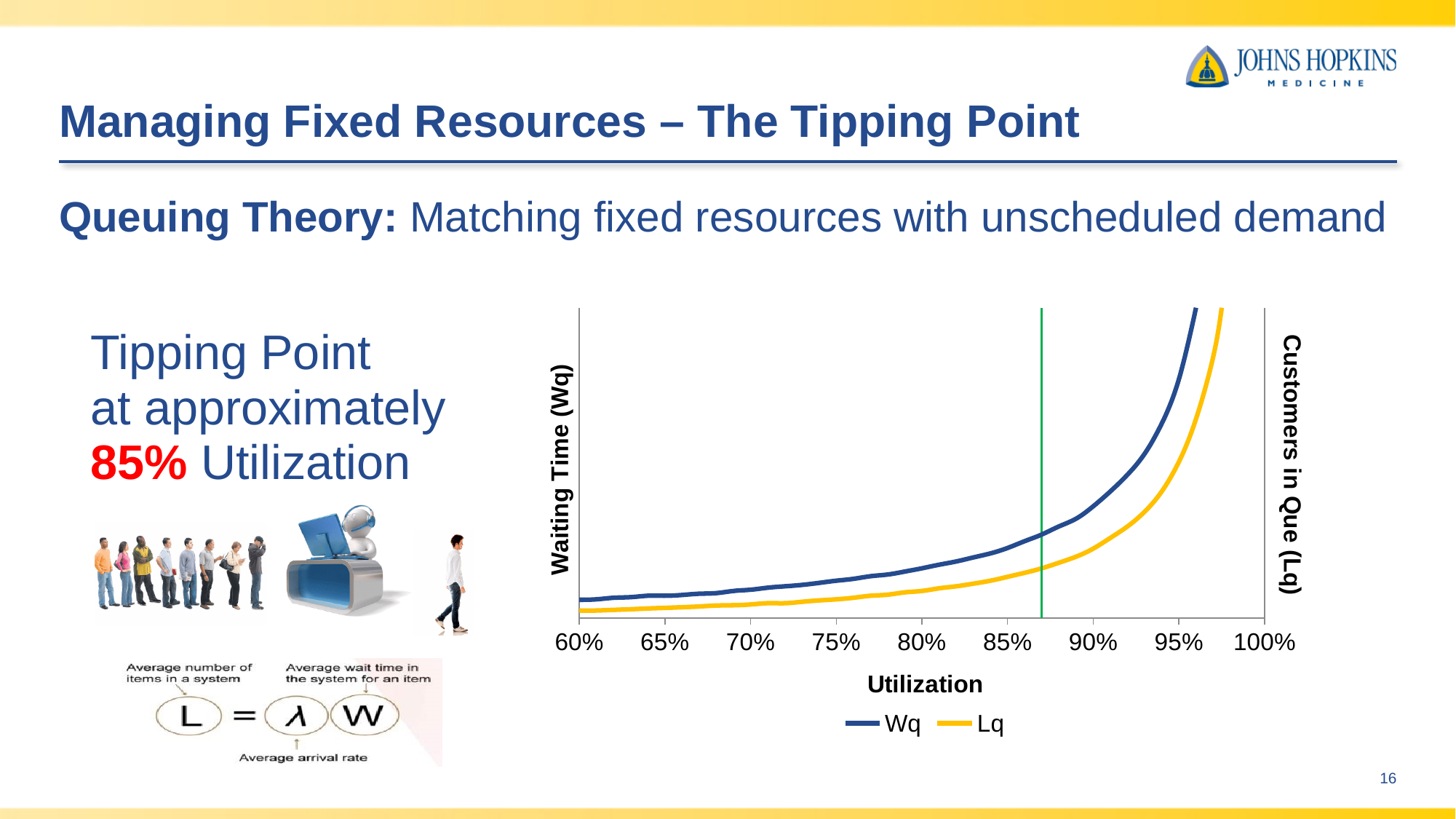
Which series is drawn in yellow on the chart? Lq What is the lowest utilization value shown on the chart's x axis? 60% What kind of chart is shown on the slide? line chart Does the Wq line rise or fall as utilization increases from 60% to 100%? rise Does the Lq line rise or fall as utilization increases along the x axis? rise How many tick labels are shown on the chart's x axis? 9 How many series does the chart legend list? 2 Is the vertical green line on the chart positioned at a utilization greater or less than 90%? less What are the two series named in the chart legend? Wq and Lq What is the highest utilization value shown on the chart's x axis? 100% Is the vertical green line on the chart positioned at a utilization greater or less than 85%? greater What is the label of the chart's x axis? Utilization